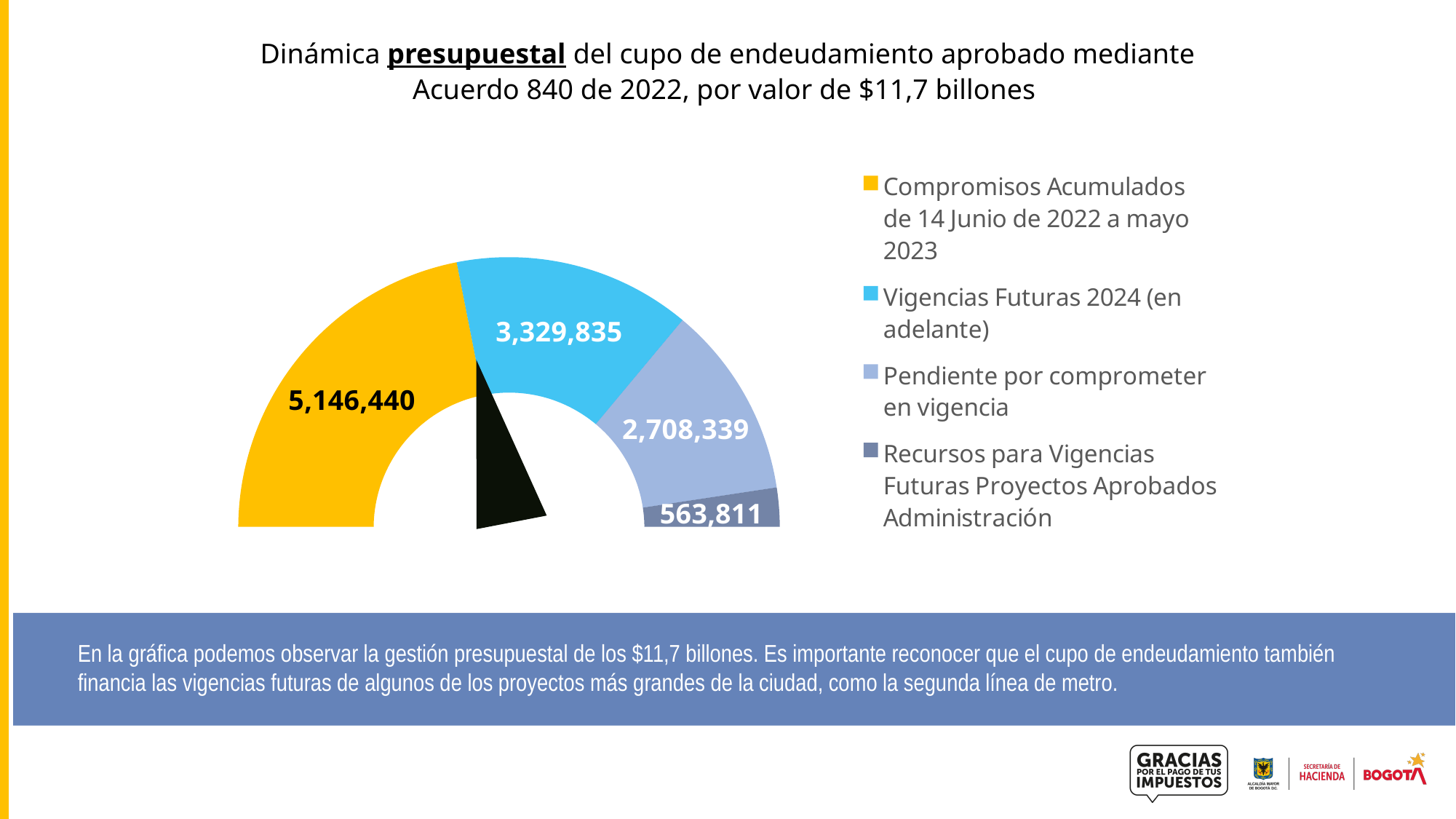
What is the difference between Pendiente por comprometer en vigencia and Recursos para Vigencias Futuras Proyectos Aprobados Administración? 2,144,528 What is the difference between Compromisos Acumulados and Vigencias Futuras 2024 (en adelante)? 1,816,605 What kind of chart is shown on the slide? Doughnut (gauge) chart Which is larger: Vigencias Futuras 2024 (en adelante) or Pendiente por comprometer en vigencia? Vigencias Futuras 2024 (en adelante) What is the value for Compromisos Acumulados de 14 Junio de 2022 a mayo 2023? 5,146,440 What is the value for Vigencias Futuras 2024 (en adelante)? 3,329,835 How many categories does the chart show? 4 Which category has the highest value? Compromisos Acumulados de 14 Junio de 2022 a mayo 2023 What colour represents Compromisos Acumulados de 14 Junio de 2022 a mayo 2023? Yellow What is the value for Recursos para Vigencias Futuras Proyectos Aprobados Administración? 563,811 Which category has the lowest value? Recursos para Vigencias Futuras Proyectos Aprobados Administración What is the value for Pendiente por comprometer en vigencia? 2,708,339